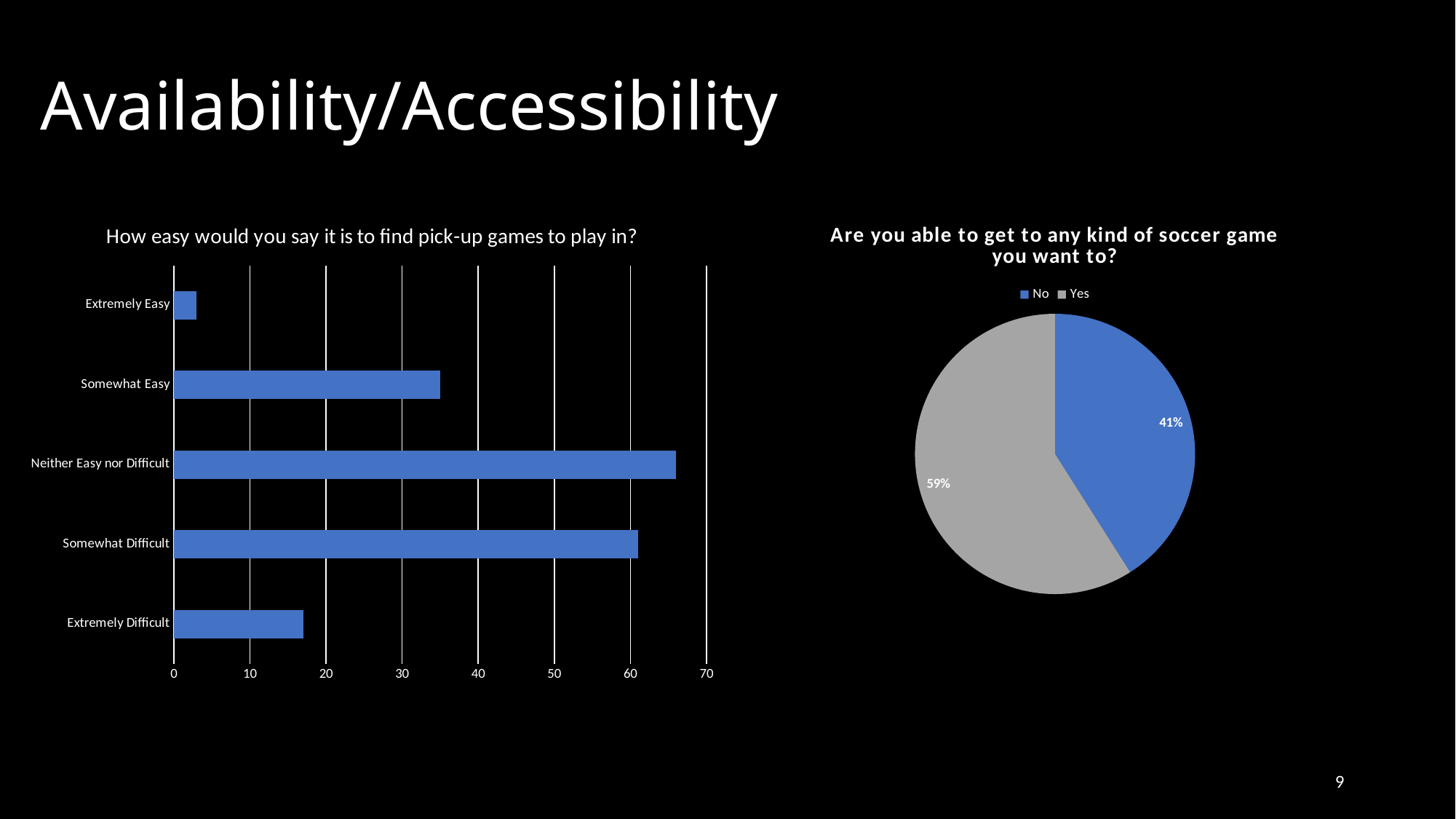
On the left chart, 'How easy would you say it is to find pick-up games to play in?', which is larger: Somewhat Easy or Extremely Difficult? Somewhat Easy On the left chart, 'How easy would you say it is to find pick-up games to play in?', is the value for Somewhat Difficult greater or less than 50? greater On the left chart, 'How easy would you say it is to find pick-up games to play in?', what kind of chart is shown? bar chart On the right chart, 'Are you able to get to any kind of soccer game you want to?', what share of responses is 'No'? 41% On the right chart, 'Are you able to get to any kind of soccer game you want to?', what share of responses is 'Yes'? 59% On the left chart, 'How easy would you say it is to find pick-up games to play in?', which category has the lowest value? Extremely Easy On the left chart, 'How easy would you say it is to find pick-up games to play in?', which category has the highest value? Neither Easy nor Difficult On the left chart, 'How easy would you say it is to find pick-up games to play in?', how many categories are plotted? 5 On the left chart, 'How easy would you say it is to find pick-up games to play in?', is the value for Somewhat Easy greater or less than 30? greater On the left chart, 'How easy would you say it is to find pick-up games to play in?', is the value for Extremely Difficult greater or less than 20? less On the right chart, 'Are you able to get to any kind of soccer game you want to?', what is the difference in percentage points between 'Yes' and 'No'? 18 On the right chart, 'Are you able to get to any kind of soccer game you want to?', how many entries does the legend list? 2